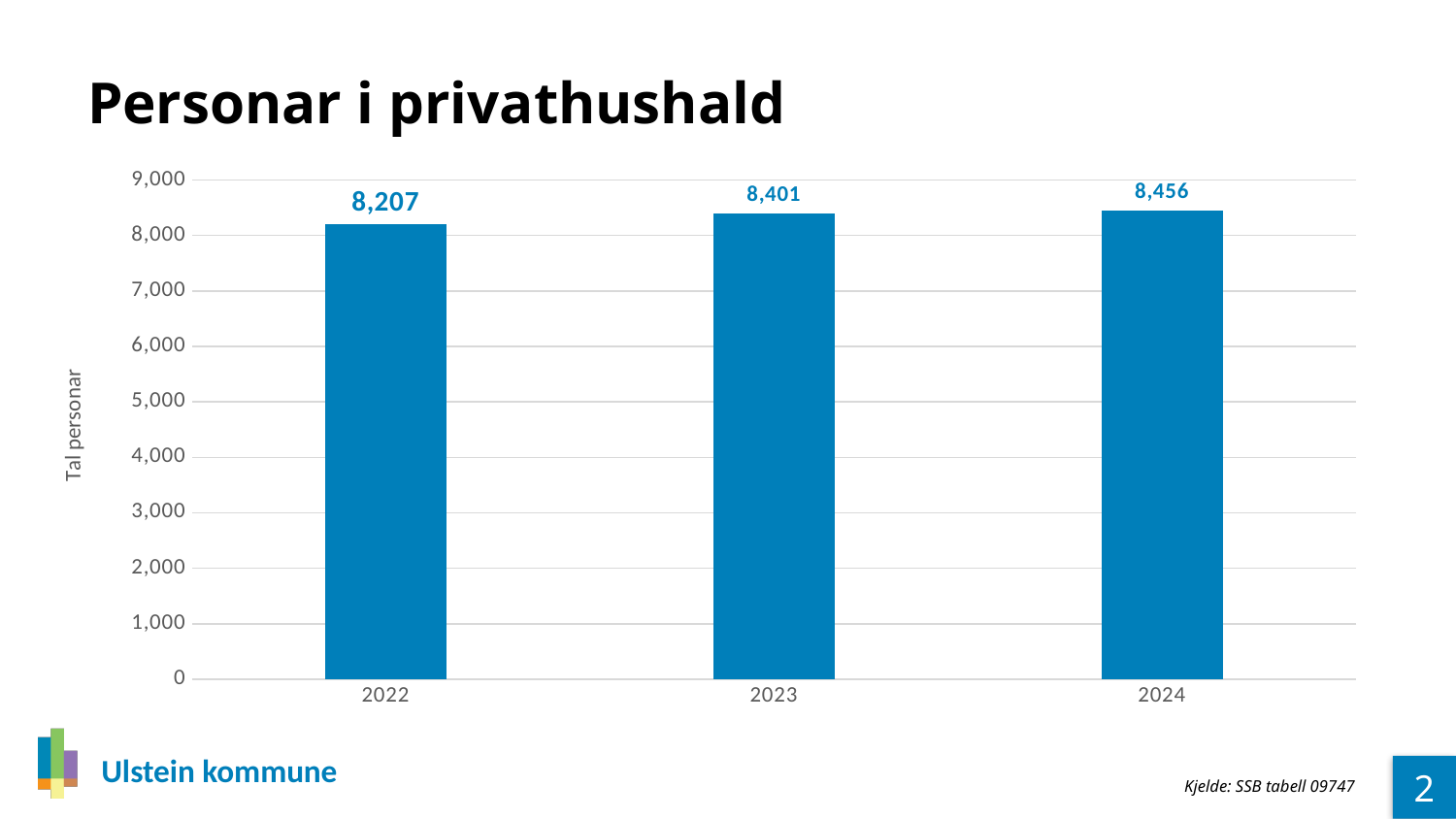
Which year has the highest value? 2024 What kind of chart is shown on the slide? bar chart What is the difference between the values for 2024 and 2022? 249 Do the values rise or fall from 2022 to 2024? rise How many years are shown on the x axis? 3 Which year has the lowest value? 2022 What is the value for 2022? 8,207 Is the value for 2022 greater or less than 8,000? greater Which is larger, the value for 2023 or the value for 2022? 2023 What is the difference between the values for 2023 and 2022? 194 What is the value for 2024? 8,456 What is the value for 2023? 8,401